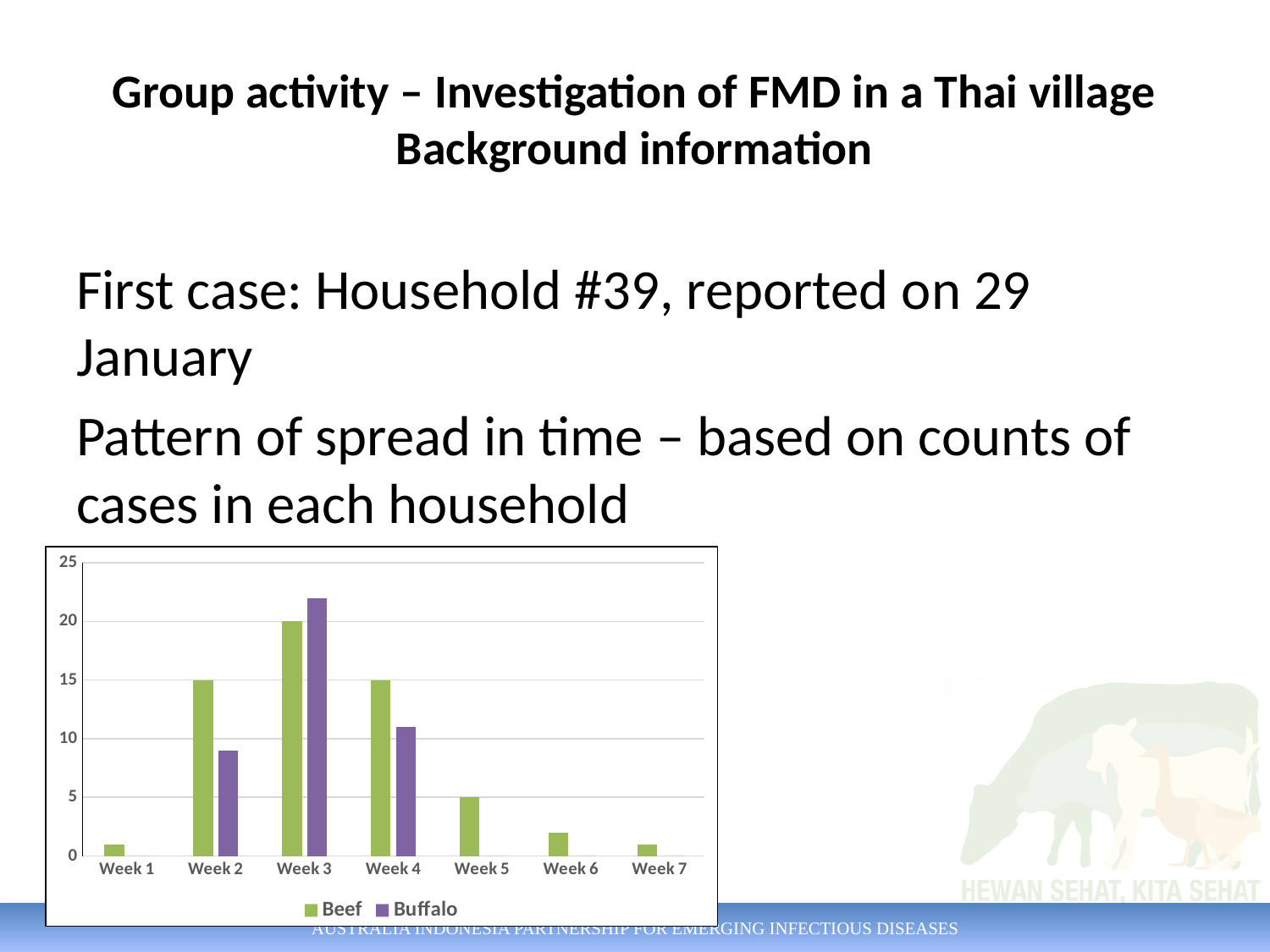
Which colour represents the Buffalo series in the chart? Purple Is the value for Buffalo in Week 3 greater or less than 20? greater Do the Beef values rise or fall from Week 3 to Week 7? Fall What is the value for Beef in Week 3? 20 What is the value for Beef in Week 5? 5 In which week is the Beef series highest? Week 3 How many series does the chart legend list? 2 In Week 2, which series has the larger value, Beef or Buffalo? Beef Is the value for Buffalo in Week 2 greater or less than 10? less What kind of chart is shown on the slide? Bar chart How many weeks are shown on the x axis of the chart? 7 What is the value for Beef in Week 2? 15